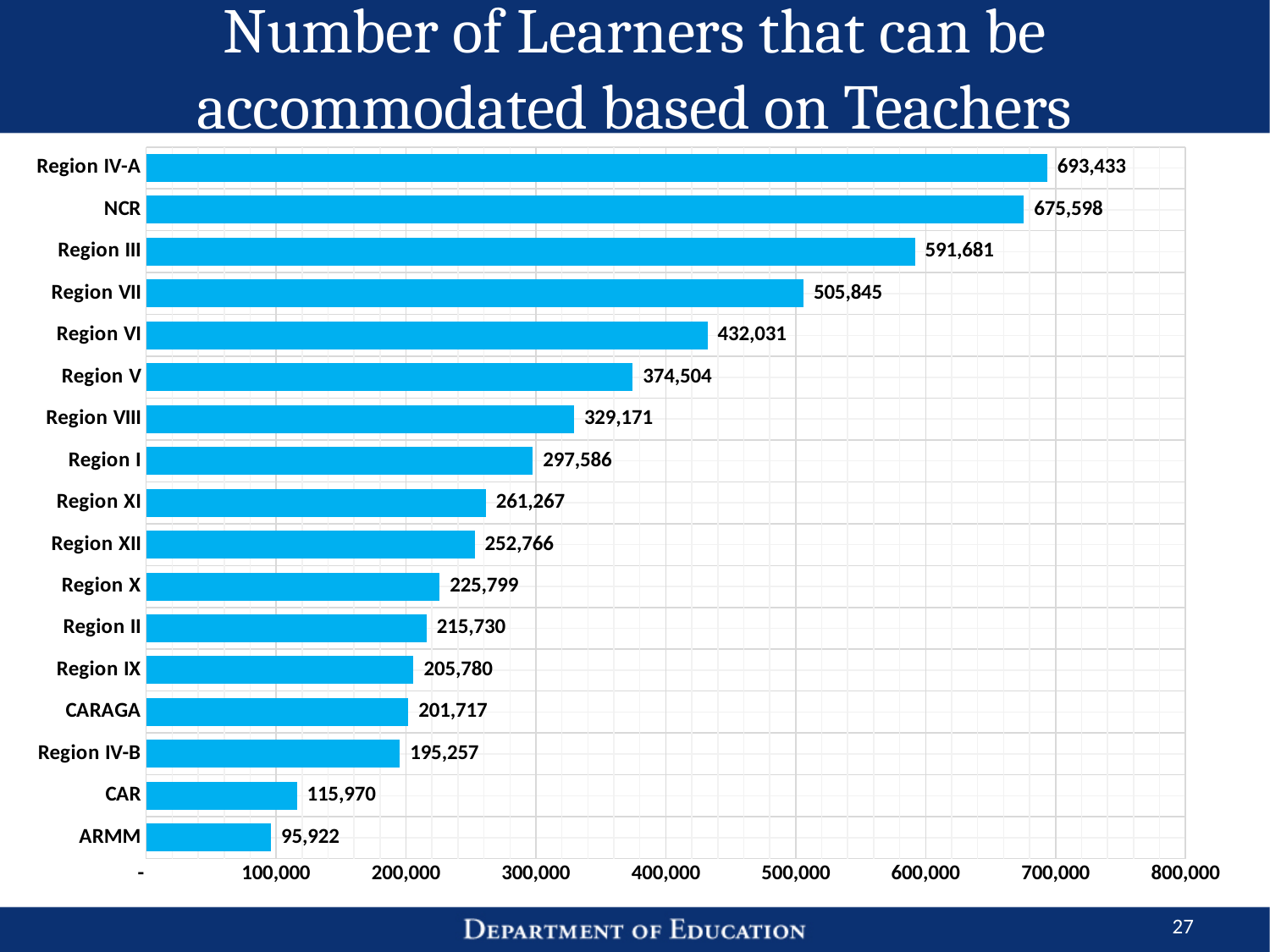
What is the difference between the values for CAR and ARMM? 20,048 What is the title of the chart? Number of Learners that can be accommodated based on Teachers What kind of chart is shown on the slide? bar chart What is the value shown for CARAGA? 201,717 What is the difference between the values for Region IV-A and NCR? 17,835 Which has a larger value, Region VII or Region VI? Region VII Which region has the lowest number of learners that can be accommodated? ARMM What is the number of learners that can be accommodated for Region IV-A? 693,433 What is the value shown for NCR? 675,598 Which region has the highest number of learners that can be accommodated? Region IV-A How many regions are shown in the chart? 17 Is the value for Region III greater or less than 600,000? less